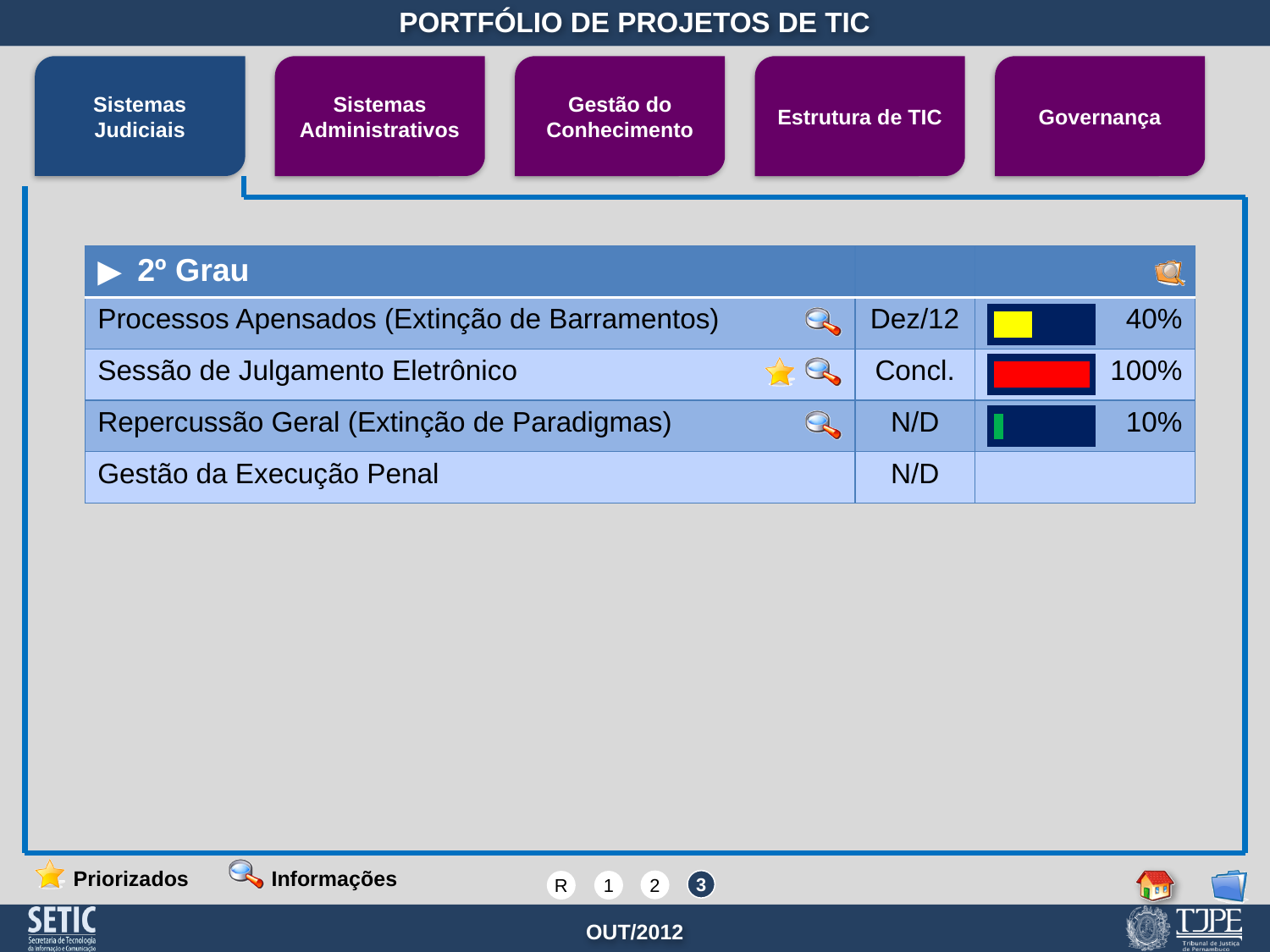
What is the difference in progress between Processos Apensados (Extinção de Barramentos) and Repercussão Geral (Extinção de Paradigmas)? 30% What is the difference in progress between Sessão de Julgamento Eletrônico and Processos Apensados (Extinção de Barramentos)? 60% What is the progress percentage shown for Repercussão Geral (Extinção de Paradigmas)? 10% Which has a higher progress percentage, Processos Apensados (Extinção de Barramentos) or Repercussão Geral (Extinção de Paradigmas)? Processos Apensados (Extinção de Barramentos) How many projects are listed in the 2º Grau table? 4 What kind of chart is used to show each project's progress in the table? Bar chart What colour is the progress bar for Sessão de Julgamento Eletrônico? Red What is the progress percentage shown for Processos Apensados (Extinção de Barramentos)? 40% How many projects in the 2º Grau table have a progress bar displayed? 3 Which project in the 2º Grau table has the highest progress percentage? Sessão de Julgamento Eletrônico Which project with a progress bar has the lowest progress percentage? Repercussão Geral (Extinção de Paradigmas) What is the progress percentage shown for Sessão de Julgamento Eletrônico? 100%